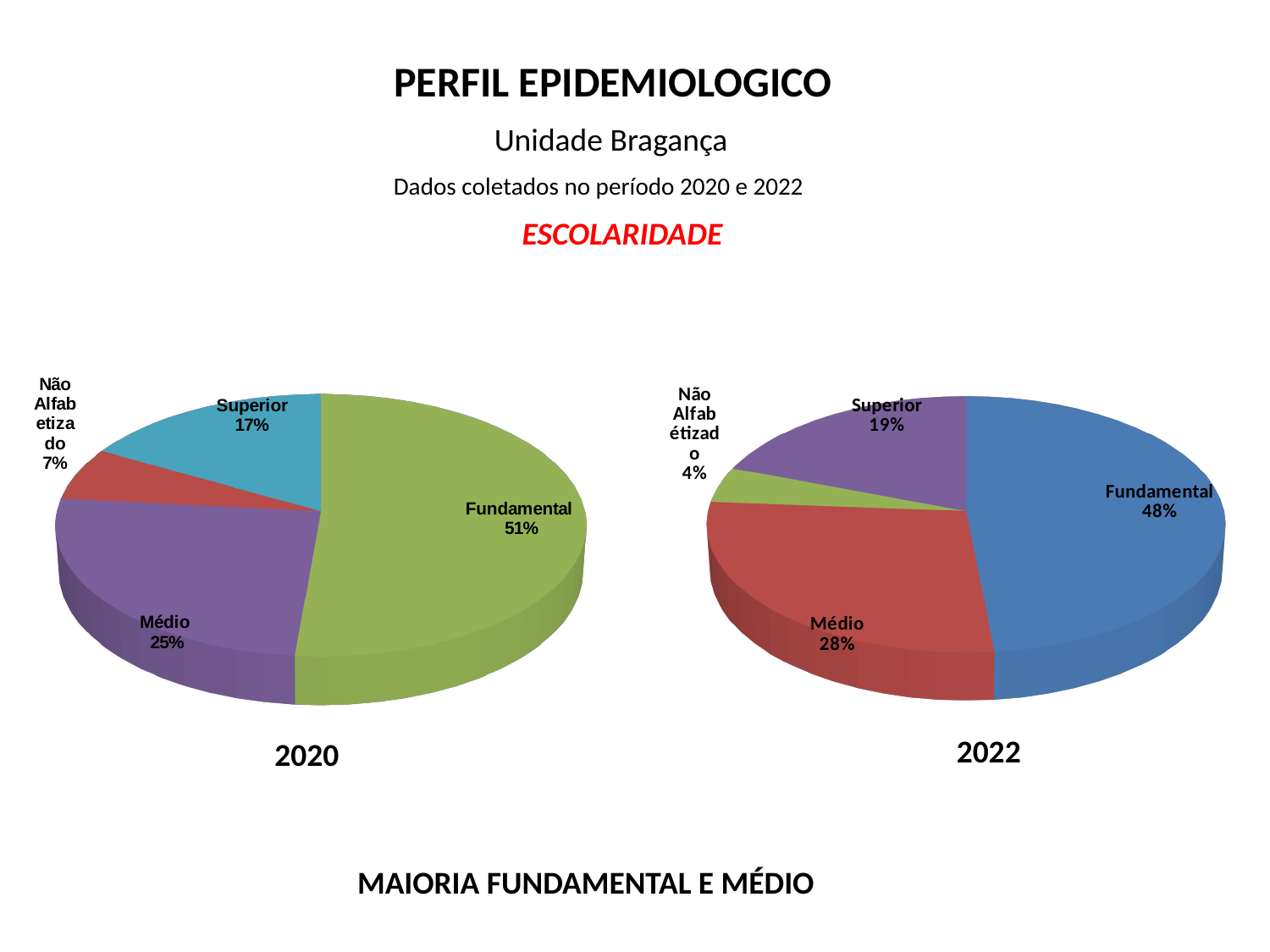
What is the title of the chart on the left? 2020 In the 2022 pie chart, what share does Superior have? 19% In the 2022 pie chart, what is the difference between the Fundamental and Médio shares? 20% In the 2020 pie chart, which category has the largest share? Fundamental Which is larger: the Superior share in 2020 or the Superior share in 2022? 2022 What kind of chart is used for the 2022 data? Pie chart How many categories does the 2020 pie chart show? 4 In the 2020 pie chart, what share does Fundamental have? 51% In the 2022 pie chart, which category has the smallest share? Não Alfabetizado In the 2022 pie chart, what share does Médio have? 28% In the 2020 pie chart, what share does Não Alfabetizado have? 7% In the 2020 pie chart, what colour is the Fundamental slice? Green